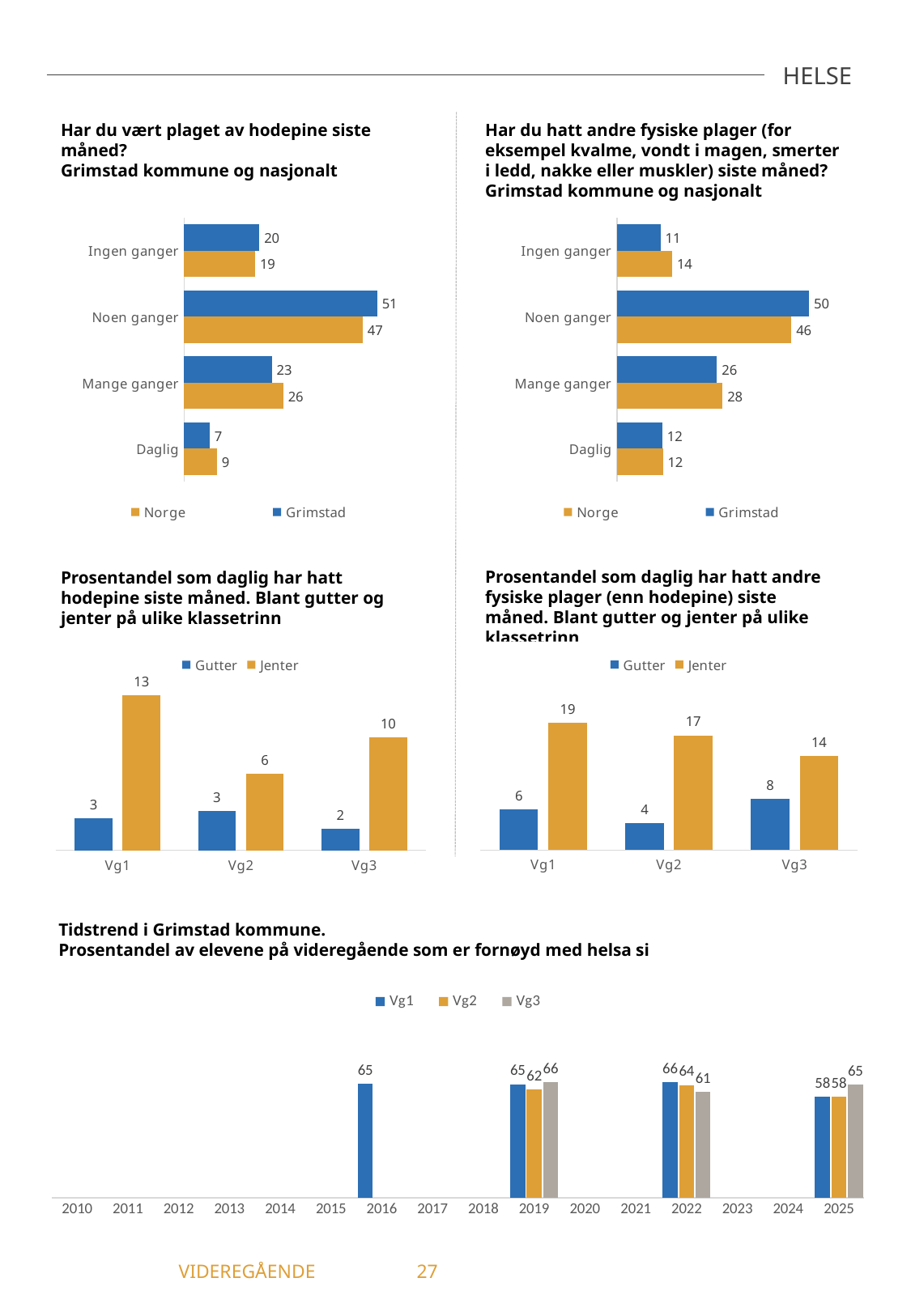
In the top-left chart 'Har du vært plaget av hodepine siste måned?', what is the value for Grimstad for 'Noen ganger'? 51 In the top-right chart 'Har du hatt andre fysiske plager...', which category has the highest Grimstad value? Noen ganger What kind of chart is the bottom chart 'Tidstrend i Grimstad kommune'? Bar chart In the top-right chart 'Har du hatt andre fysiske plager...', what is the value for Norge for 'Ingen ganger'? 14 In the top-left chart 'Har du vært plaget av hodepine siste måned?', what is the difference between the Norge and Grimstad values for 'Mange ganger'? 3 In the bottom chart 'Tidstrend i Grimstad kommune', which series has the highest value in 2025? Vg3 In the middle-left chart 'Prosentandel som daglig har hatt hodepine siste måned', what is the value for Jenter at Vg1? 13 In the middle-right chart 'Prosentandel som daglig har hatt andre fysiske plager', how many series does the legend list? 2 In the bottom chart 'Tidstrend i Grimstad kommune', what is the value for Vg2 in 2022? 64 In the middle-right chart 'Prosentandel som daglig har hatt andre fysiske plager', what is the difference between Jenter and Gutter at Vg2? 13 In the middle-left chart 'Prosentandel som daglig har hatt hodepine siste måned', which class level has the lowest value for Gutter? Vg3 In the top-right chart 'Har du hatt andre fysiske plager...', is the Grimstad value for 'Daglig' larger than the Norge value for 'Daglig'? No, they are equal (12)